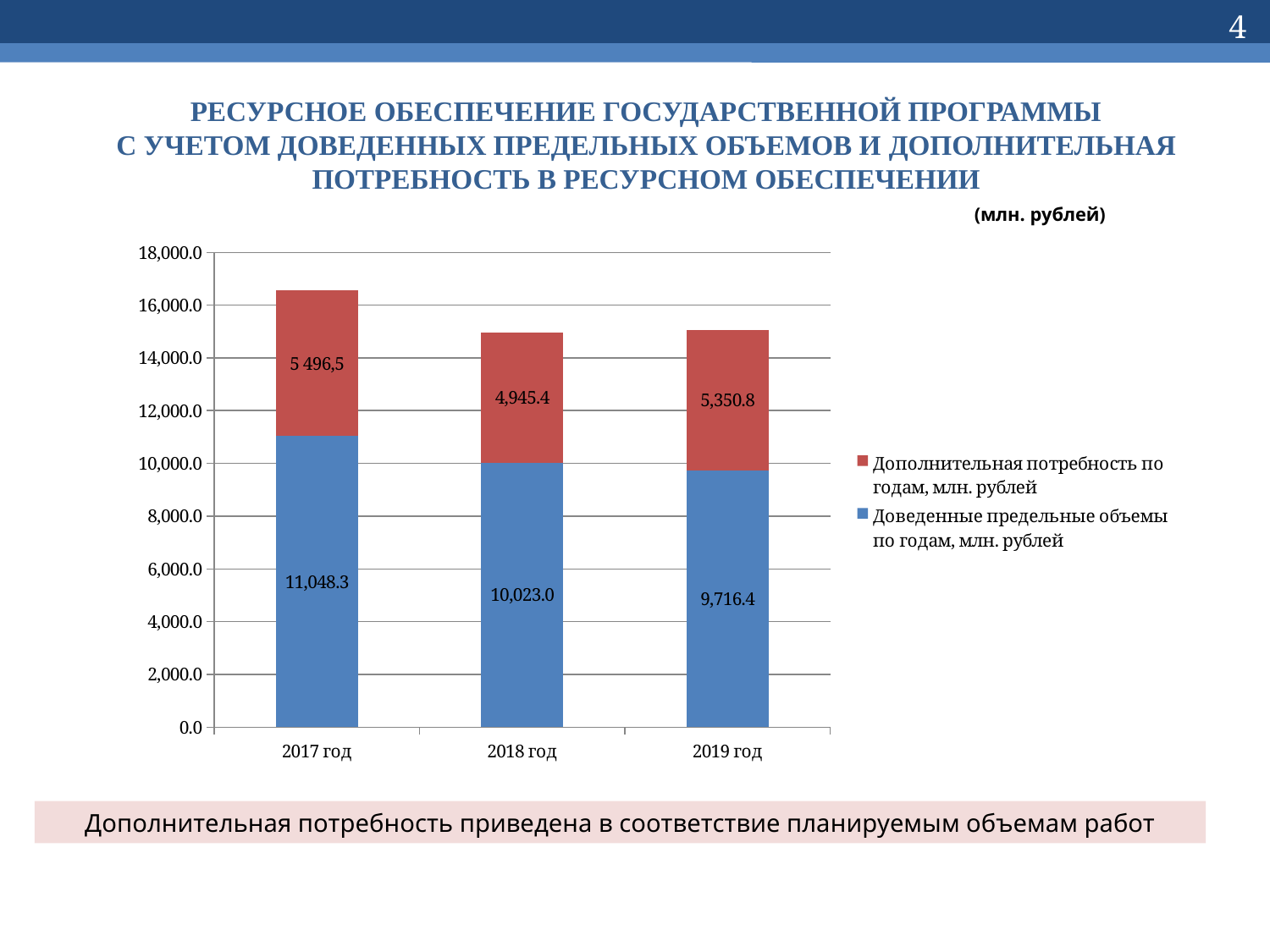
Does the 'Доведенные предельные объемы по годам' series rise or fall from 2017 год to 2019 год? fall Which year has the highest value for the 'Доведенные предельные объемы по годам' series? 2017 год Which is larger: the 'Дополнительная потребность по годам' value for 2019 год or for 2018 год? 2019 год What is the total height of the stacked bar for 2018 год? 14,968.4 How many years are shown on the x axis of the chart? 3 What is the value of the 'Доведенные предельные объемы по годам' series for 2017 год? 11,048.3 How many series does the chart legend list? 2 What is the difference between the 'Доведенные предельные объемы по годам' values for 2017 год and 2018 год? 1,025.3 Which year has the lowest value for the 'Дополнительная потребность по годам' series? 2018 год What is the value of the 'Дополнительная потребность по годам' series for 2019 год? 5,350.8 What is the value of the 'Доведенные предельные объемы по годам' series for 2019 год? 9,716.4 What is the value of the 'Дополнительная потребность по годам' series for 2018 год? 4,945.4